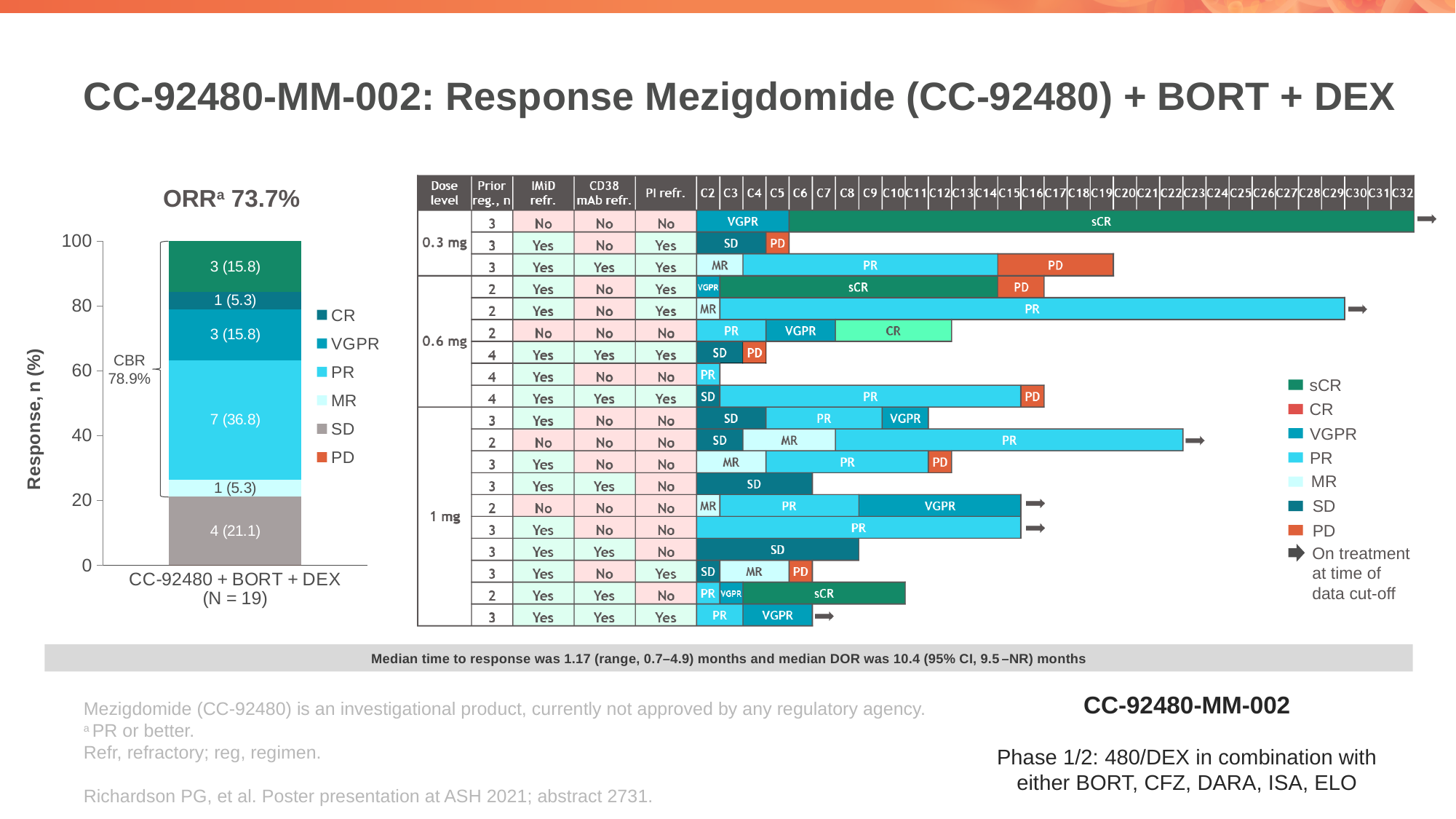
What kind of chart is the chart on the left of the slide (ORR 73.7%)? Stacked bar chart In the swimmer plot on the right, how many dose levels are shown? 3 How many entries does the legend of the stacked bar chart on the left list? 6 In the stacked bar chart on the left, what is the value shown for the SD segment? 4 (21.1) In the stacked bar chart on the left, how many more patients had PR than SD? 3 In the stacked bar chart on the left, what is the value shown for the MR segment? 1 (5.3) What ORR value is shown above the stacked bar chart on the left? 73.7% In the stacked bar chart on the left, what is the value shown for the VGPR segment? 3 (15.8) What CBR value is annotated on the stacked bar chart on the left? 78.9% In the stacked bar chart on the left, which response category has the largest segment? PR In the stacked bar chart on the left, which segment is larger, SD or VGPR? SD In the stacked bar chart on the left, what is the value shown for the PR segment? 7 (36.8)